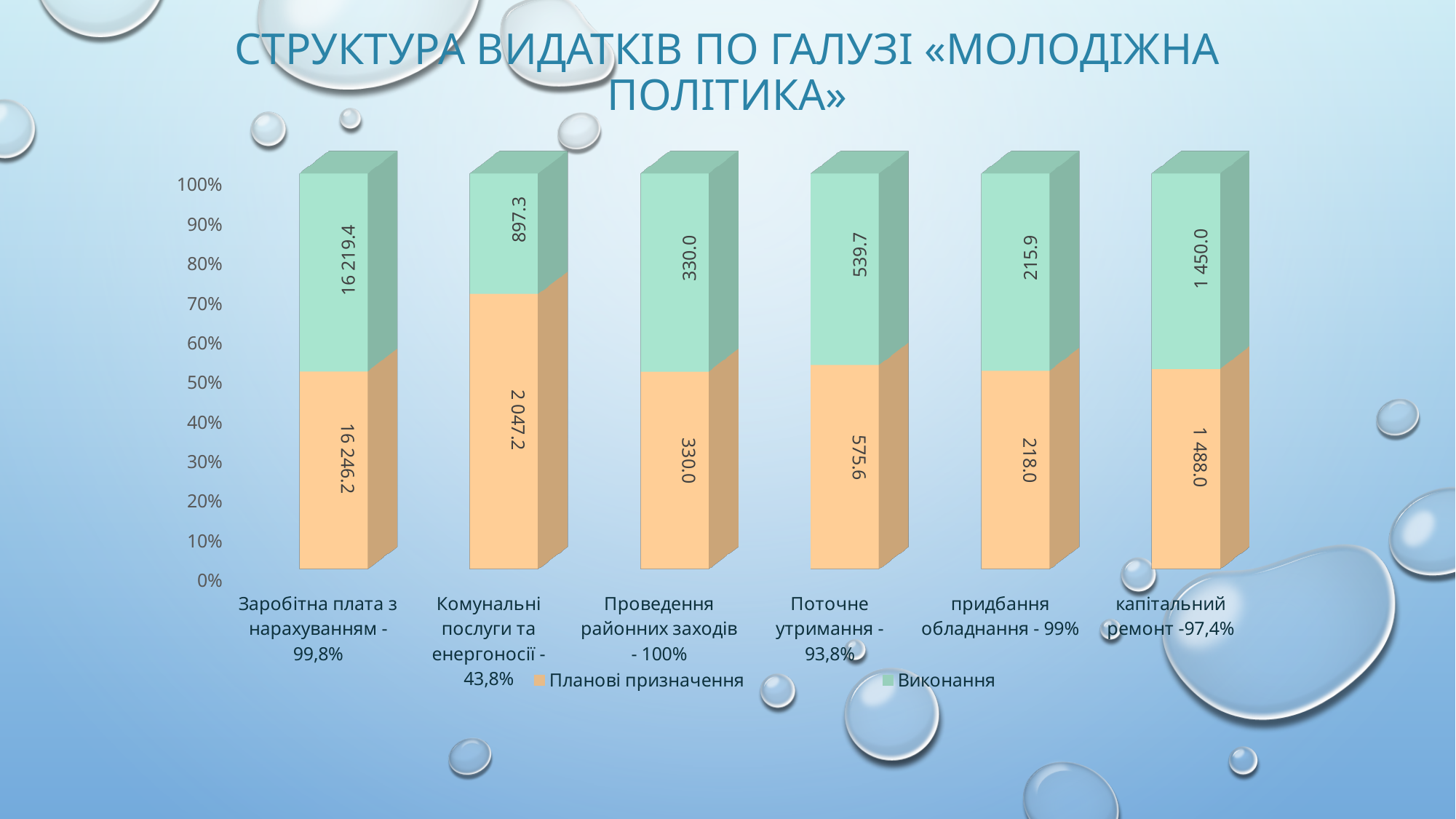
Which is larger: Виконання for капітальний ремонт or Виконання for Комунальні послуги та енергоносії? капітальний ремонт What is the value of Виконання for капітальний ремонт? 1 450.0 What is the difference between Планові призначення and Виконання for Заробітна плата з нарахуванням? 26.8 How many series does the legend list? 2 What is the difference between Планові призначення and Виконання for Комунальні послуги та енергоносії? 1 149.9 How many categories are shown on the x axis? 6 What is the value of Виконання for Поточне утримання? 539.7 Which category has the lowest value of Виконання? придбання обладнання Which category has the highest value of Планові призначення? Заробітна плата з нарахуванням What kind of chart is shown on the slide? Stacked bar chart What is the value of Планові призначення for придбання обладнання? 218.0 What is the value of Планові призначення for Комунальні послуги та енергоносії? 2 047.2